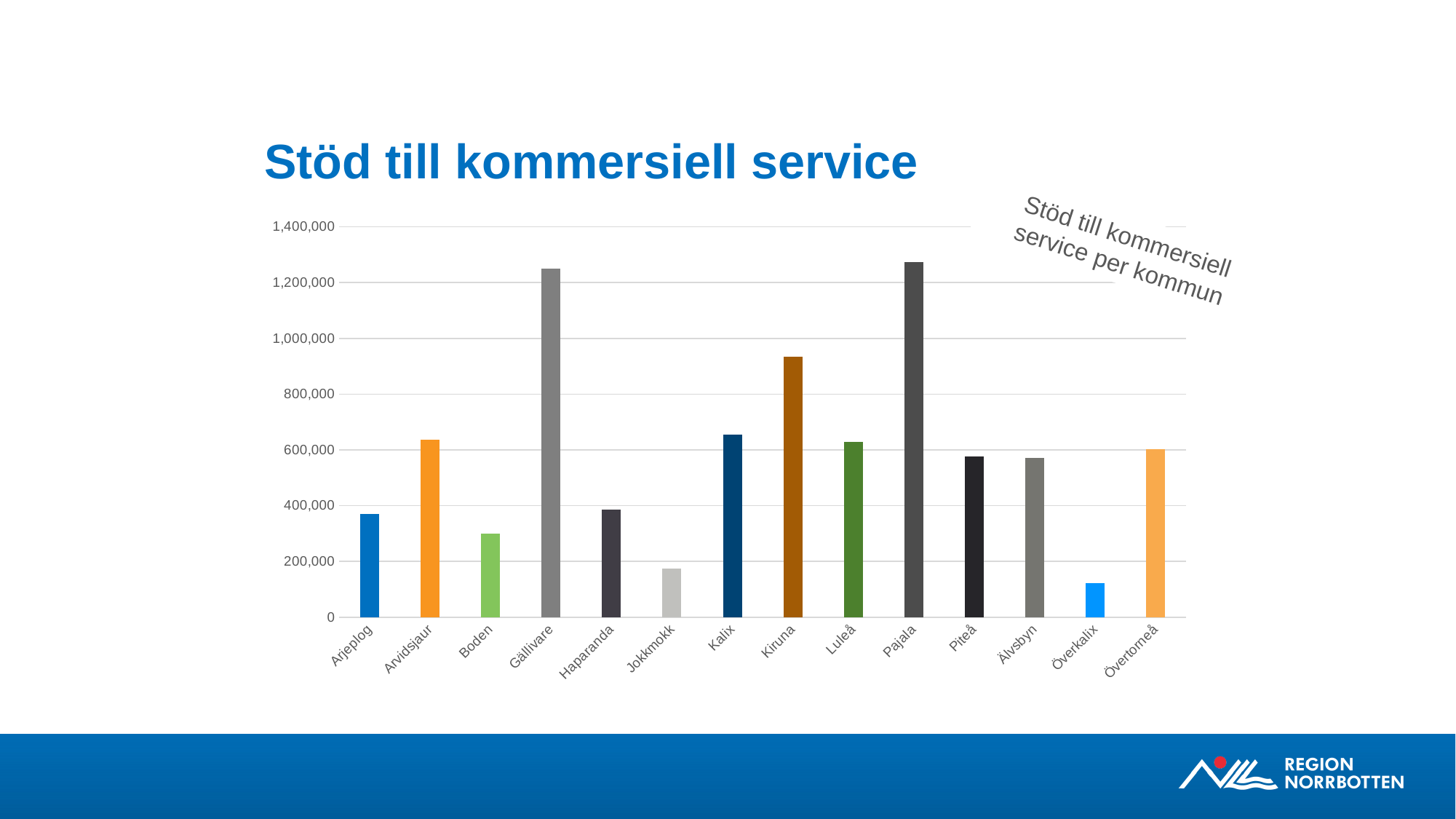
What does the rotated text next to the chart say? Stöd till kommersiell service per kommun Is the value for Kiruna greater or less than 800,000? greater Is the value for Överkalix greater or less than 200,000? less What kind of chart is shown on the slide? Bar chart Which has a larger value, Kiruna or Kalix? Kiruna Is the value for Boden greater or less than 400,000? less Which municipality has the lowest value in the chart? Överkalix Which has a larger value, Haparanda or Luleå? Luleå How many municipalities (categories) are shown on the x axis of the chart? 14 What is the title of the slide? Stöd till kommersiell service